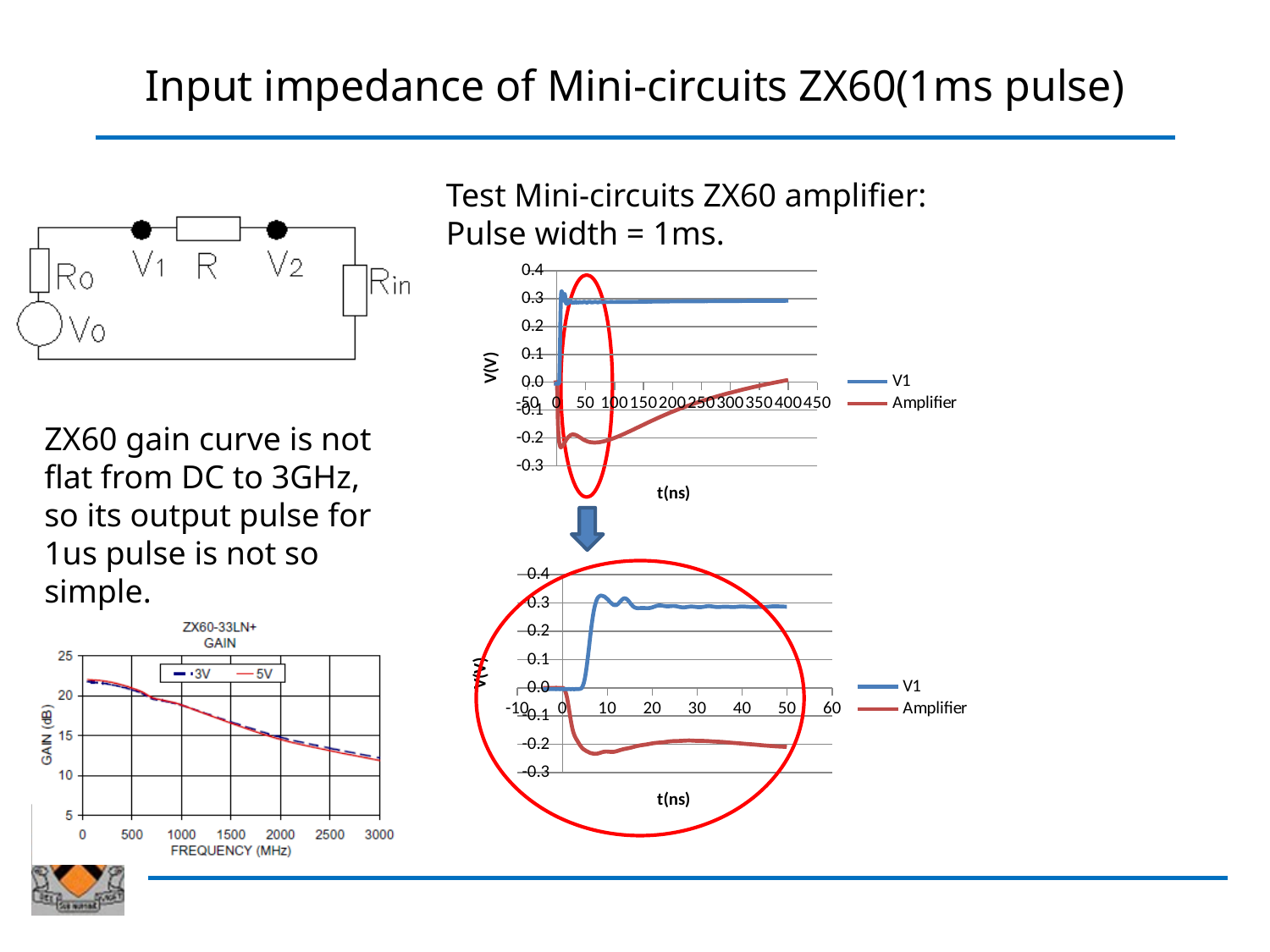
In the top-right chart, is the Amplifier value at t = 50 ns greater or less than -0.1? less In the top-right chart, which series has the larger value at t = 200 ns, V1 or Amplifier? V1 In the top-right chart, is the V1 value at t = 200 ns greater or less than 0.2? greater In the top-right chart (t from -50 to 450 ns), how many series does the legend list? 2 In the bottom-left gain chart, is the gain at 3000 MHz greater or less than 15 dB? less In the bottom-left gain chart, how many series does the legend list? 2 What is the x-axis label of the bottom-right chart? t(ns) In the top-right chart, does the Amplifier curve rise or fall between t = 50 ns and t = 400 ns? rise In the bottom-left gain chart, does the gain rise or fall as frequency increases from 0 to 3000 MHz? fall What kind of chart is the top-right chart with V1 and Amplifier series? line chart